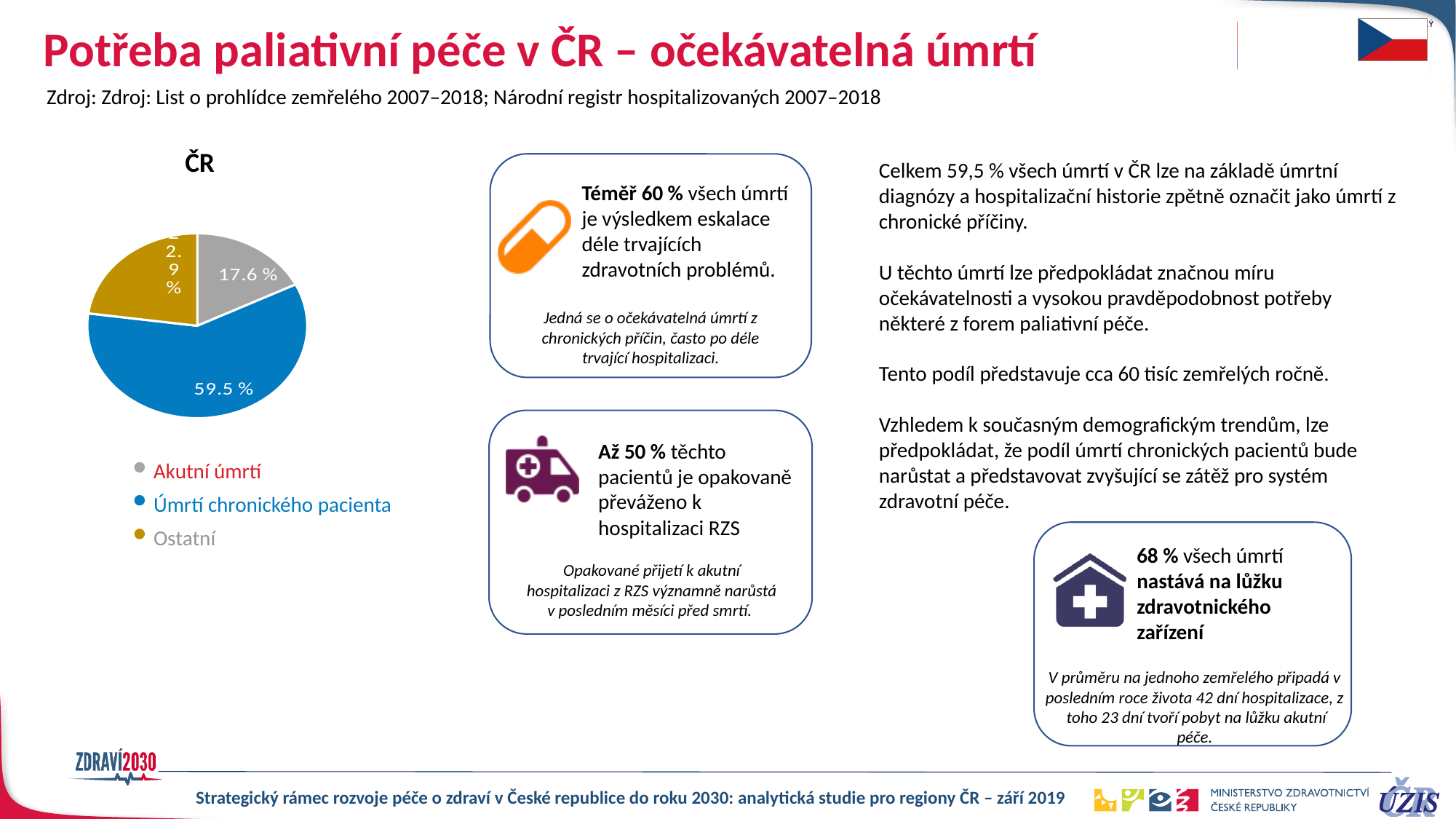
How many slices does the pie chart have? 3 What is the title of the pie chart? ČR What share of the pie does Úmrtí chronického pacienta represent? 59.5 % What is the value for Úmrtí chronického pacienta in the pie chart? 59.5 % Which category has the largest slice in the pie chart? Úmrtí chronického pacienta What is the value for Akutní úmrtí in the pie chart? 17.6 % Which legend entry is shown in blue? Úmrtí chronického pacienta Which is larger in the pie chart, Akutní úmrtí or Úmrtí chronického pacienta? Úmrtí chronického pacienta Which category has the smallest slice in the pie chart? Akutní úmrtí What is the difference in percentage points between Úmrtí chronického pacienta and Akutní úmrtí? 41.9 What kind of chart is shown on the slide? pie chart